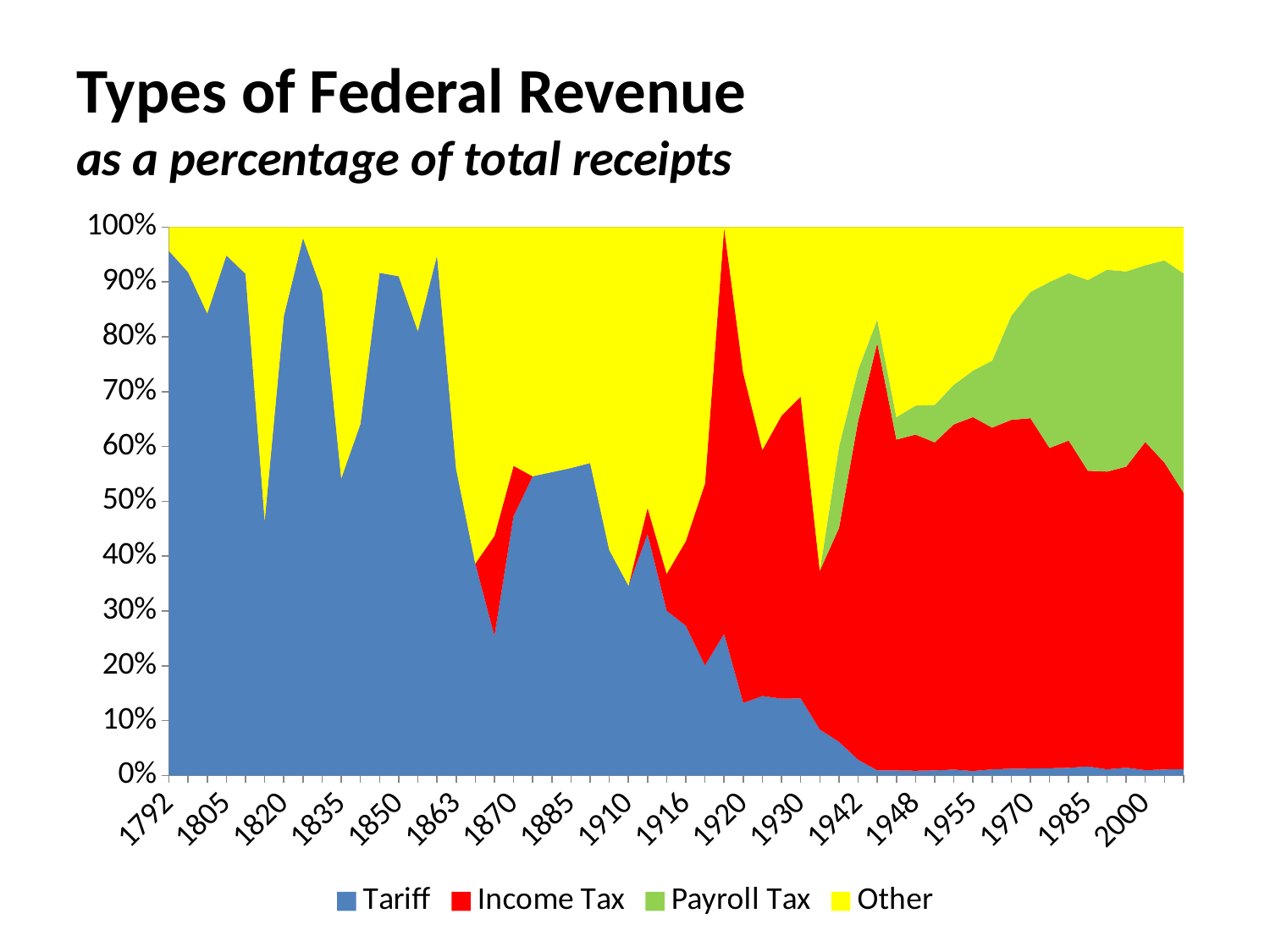
Does the Tariff share generally rise or fall from 1792 to 2000? fall Which series is shown in green in the legend? Payroll Tax Which series makes up the largest share of receipts in 1970? Income Tax Which series makes up the largest share of receipts in 1792? Tariff Is the Tariff share in 2000 greater or less than 10%? less How many series does the legend list? 4 How many year labels are shown on the x axis? 18 Which series makes up the smallest share of receipts in 2000? Tariff Is the Tariff share in 1820 greater or less than 50%? greater Is the Tariff share in 1792 greater or less than 90%? greater What kind of chart is shown on the slide? Stacked area chart What is the title of the chart? Types of Federal Revenue as a percentage of total receipts